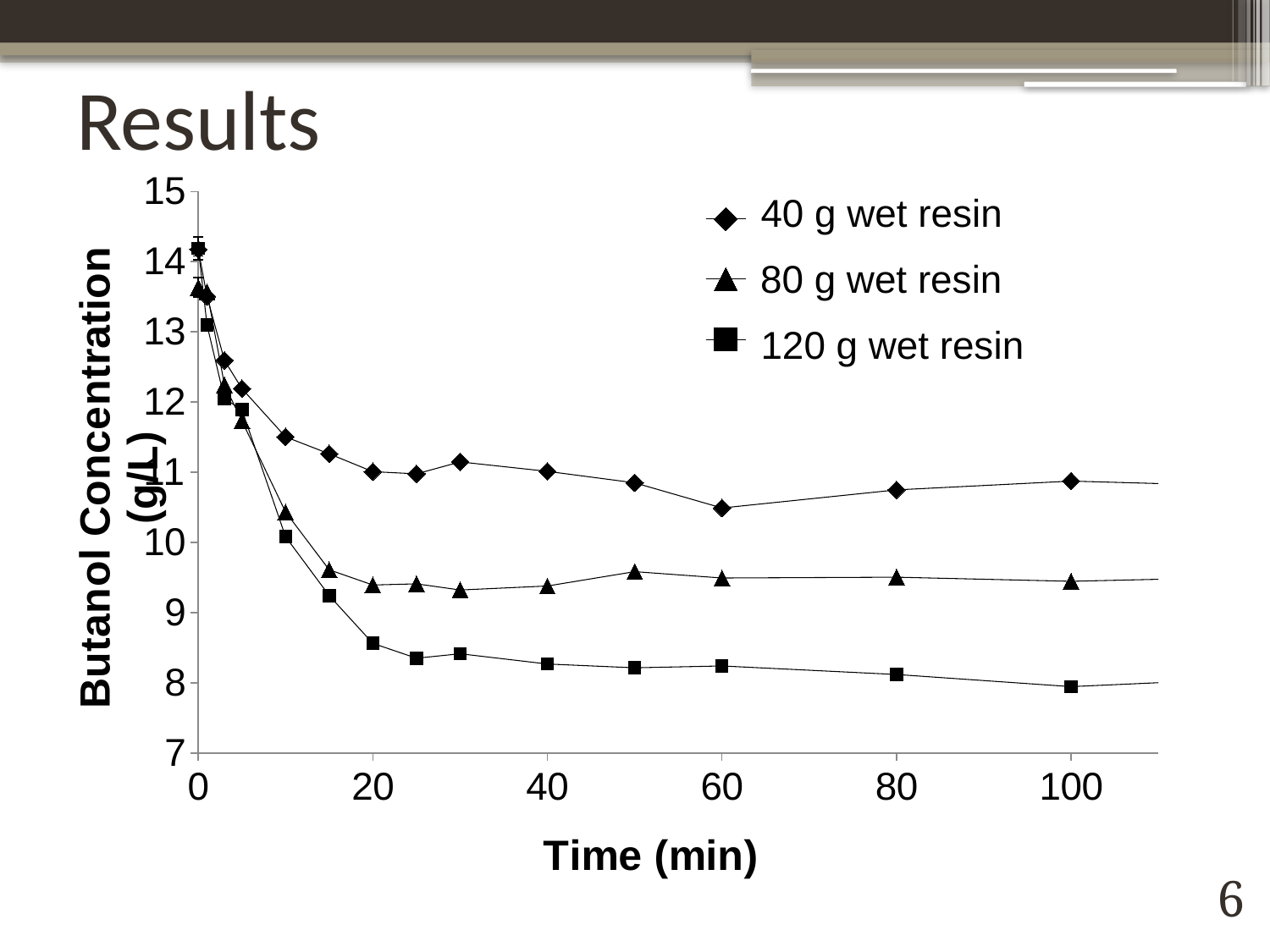
Do the values for 120 g wet resin rise or fall as time increases along the x axis? fall Which series has the lowest butanol concentration at 60 min? 120 g wet resin Is the value for 80 g wet resin at 100 min greater or less than 10? less Is the value for 40 g wet resin at 10 min greater or less than 11? greater What are the three series listed in the legend? 40 g wet resin, 80 g wet resin, 120 g wet resin Is the value for 120 g wet resin at 20 min greater or less than 9? less What kind of chart is shown on the slide? line chart At 20 min, which is larger: the value for 80 g wet resin or for 120 g wet resin? 80 g wet resin Which series has the highest butanol concentration at 100 min? 40 g wet resin How many series does the legend list? 3 What is the label of the y axis? Butanol Concentration (g/L)